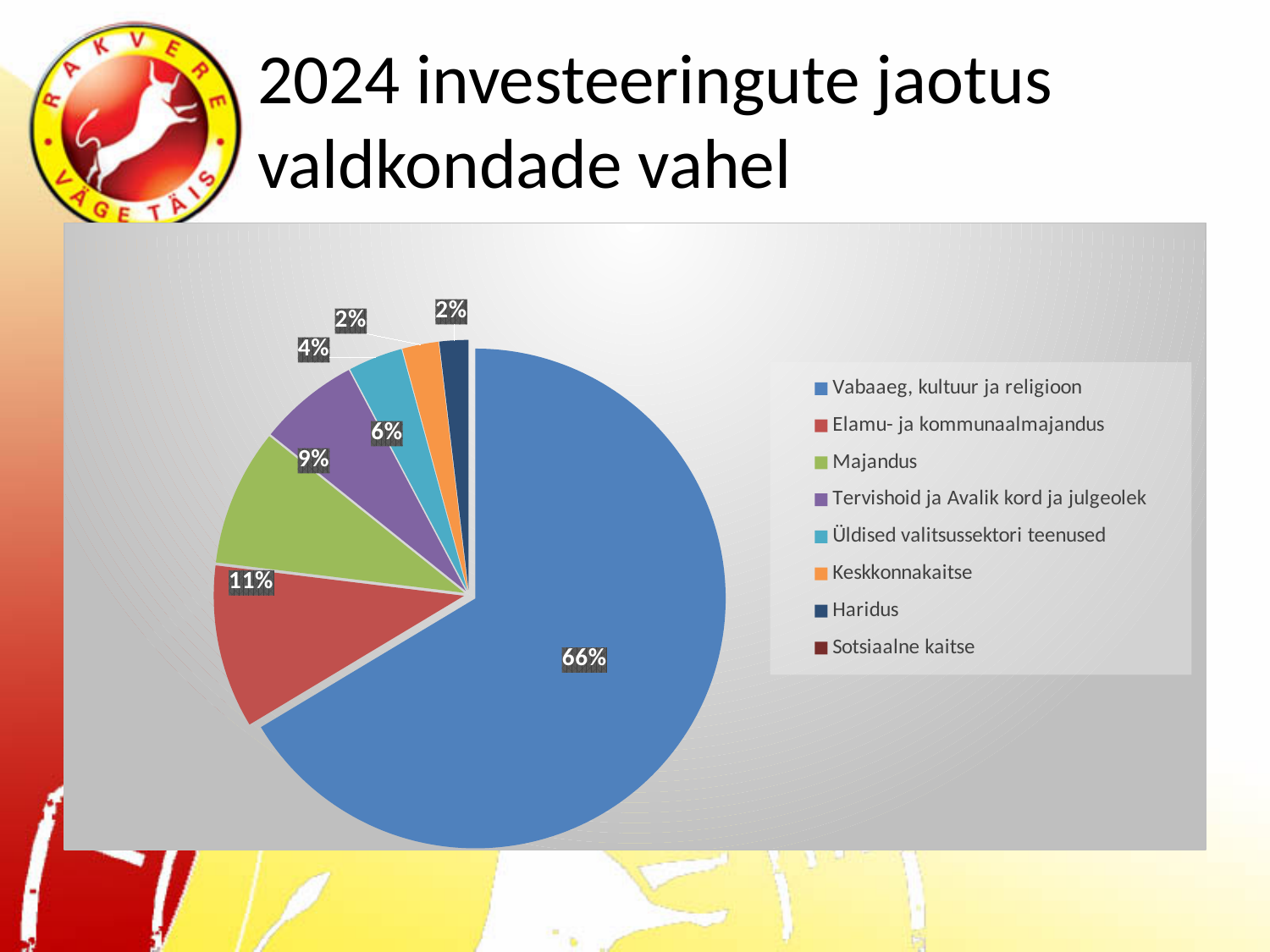
What kind of chart is shown on the slide? Pie chart What share of the pie does Elamu- ja kommunaalmajandus have? 11% What share of the pie does Vabaaeg, kultuur ja religioon have? 66% What is the title of the slide? 2024 investeeringute jaotus valdkondade vahel How many categories does the legend list? 8 What share of the pie does Tervishoid ja Avalik kord ja julgeolek have? 6% Which is larger, the slice for Majandus or the slice for Tervishoid ja Avalik kord ja julgeolek? Majandus What share of the pie does Majandus have? 9% Which category has the largest slice of the pie? Vabaaeg, kultuur ja religioon What share of the pie does Üldised valitsussektori teenused have? 4% What is the difference in percentage points between the Vabaaeg, kultuur ja religioon slice and the Elamu- ja kommunaalmajandus slice? 55 percentage points What share of the pie does Keskkonnakaitse have? 2%